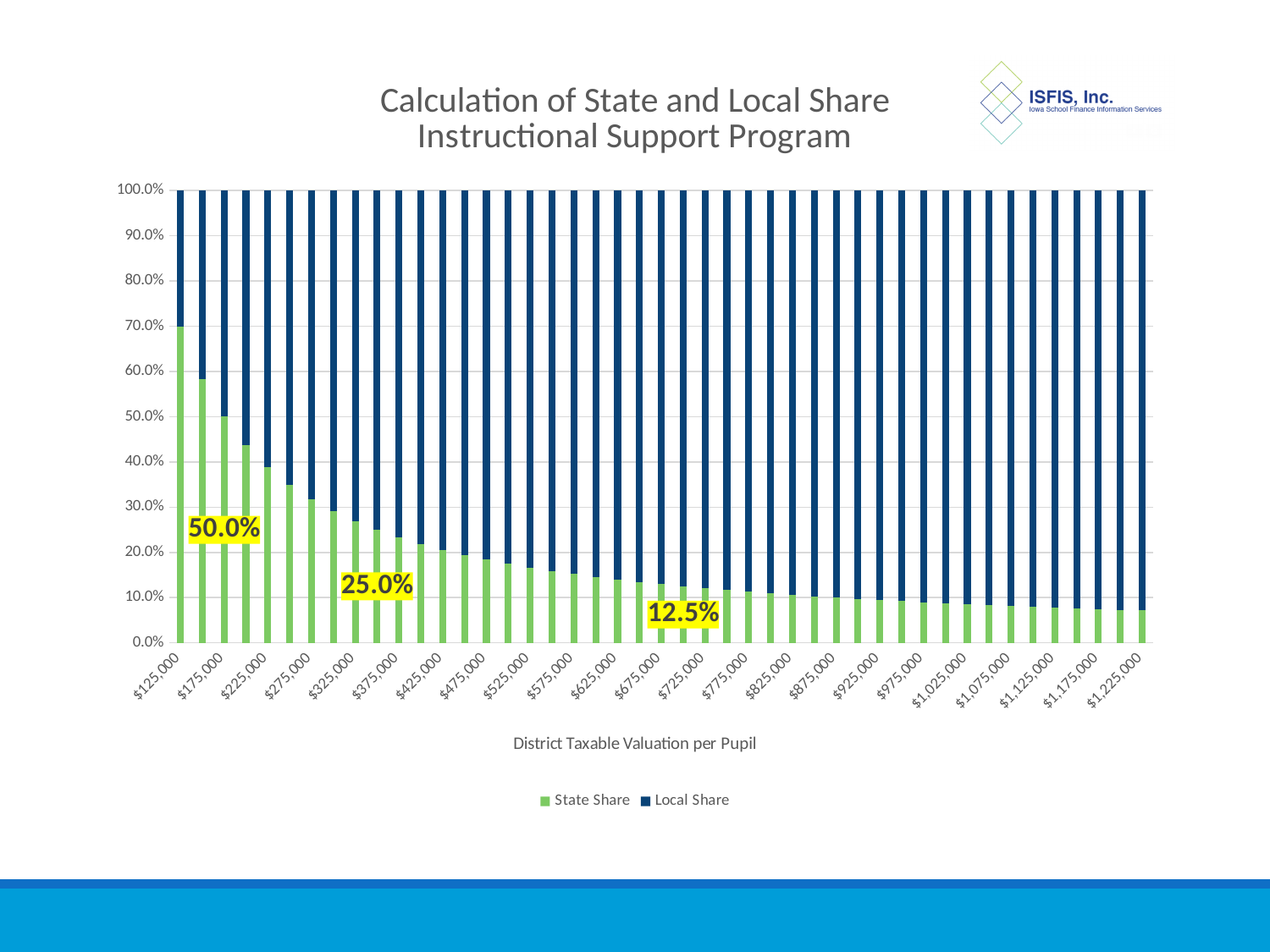
Is the State Share for $1,225,000 greater or less than 10.0%? less What are the two series named in the legend? State Share and Local Share What total does each stacked bar reach? 100.0% What kind of chart is shown on the slide? Stacked bar chart Which is larger, the State Share for $125,000 or the State Share for $1,225,000? $125,000 Is the Local Share for $125,000 greater or less than 50.0%? less Which labeled valuation has the highest State Share? $125,000 Is the State Share for $625,000 greater or less than 20.0%? less How many series does the legend list? 2 What is the title of the x axis? District Taxable Valuation per Pupil Does the State Share rise or fall as District Taxable Valuation per Pupil increases? Fall